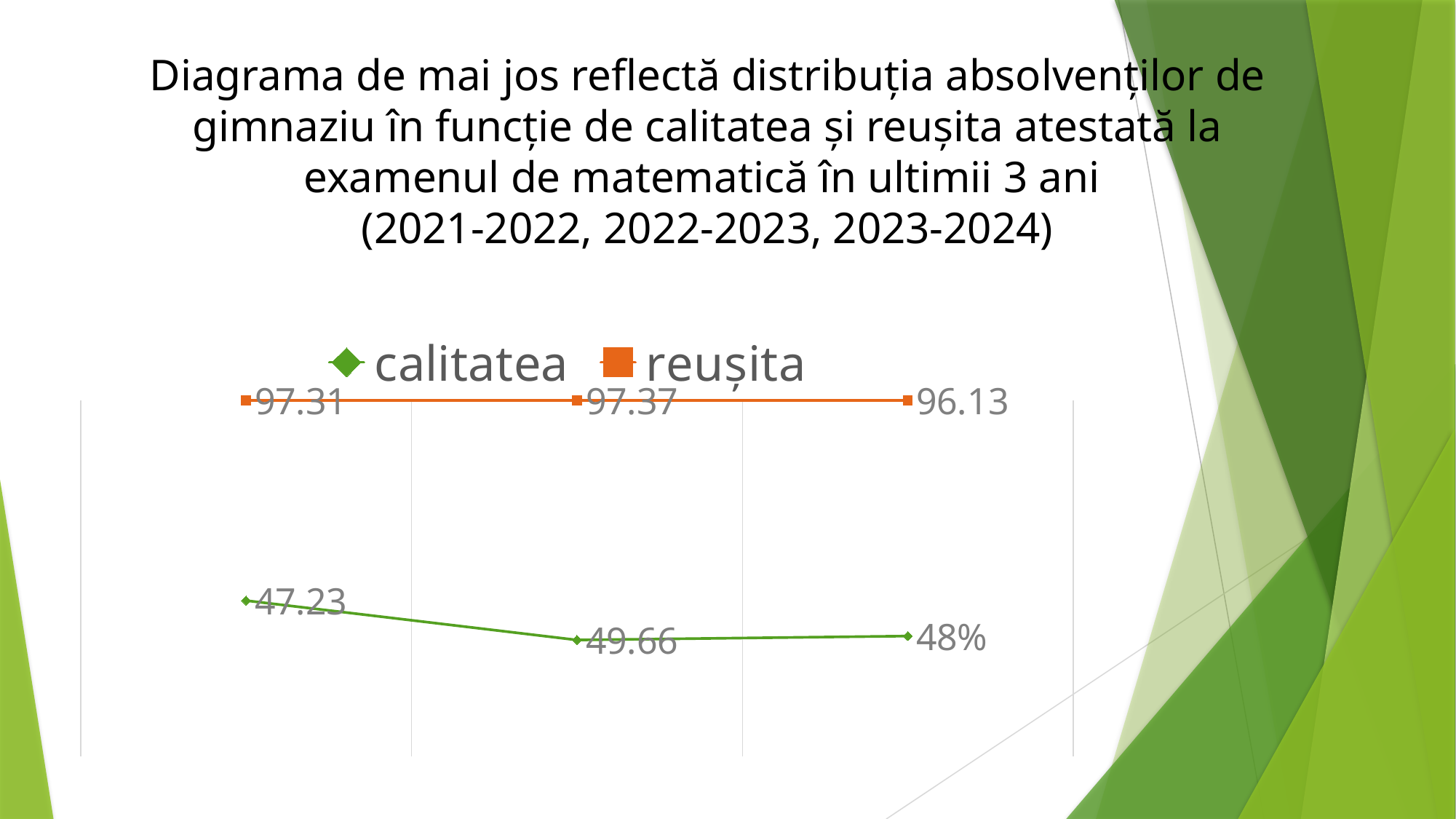
What kind of chart is shown on the slide? line chart What is the value of the first (leftmost) point of the reușita series? 97.31 Which point of the reușita series has the lowest value? the last (rightmost) point, 96.13 What is the value of the second (middle) point of the reușita series? 97.37 How many series does the chart legend list? 2 What are the names of the two series in the chart legend? calitatea and reușita How many data points does each series in the chart have? 3 What is the difference between the second and third values of the reușita series (97.37 and 96.13)? 1.24 What is the value of the second (middle) point of the calitatea series? 49.66 What is the value of the last (rightmost) point of the calitatea series? 48% What is the value of the last (rightmost) point of the reușita series? 96.13 What is the value of the first (leftmost) point of the calitatea series? 47.23